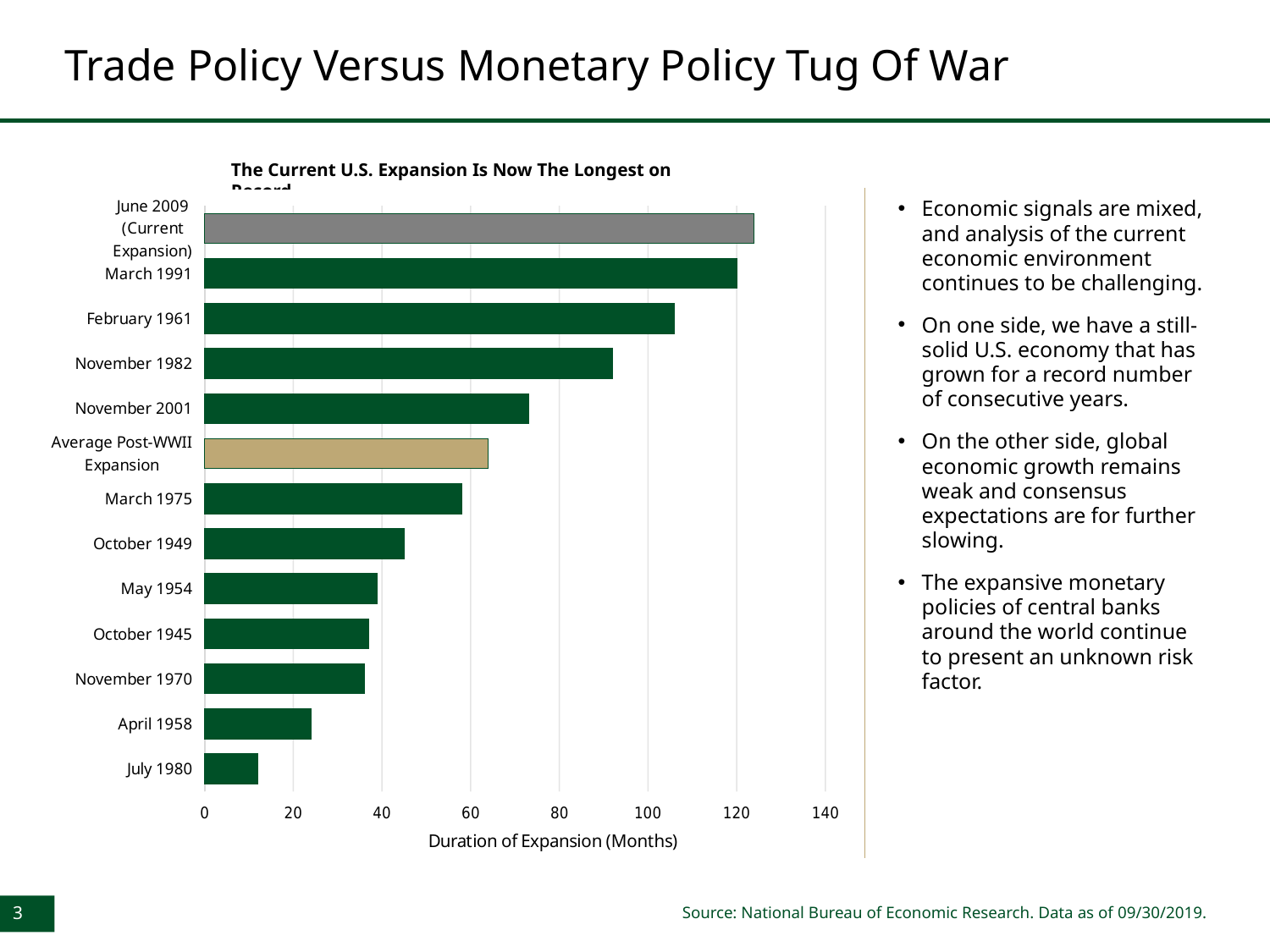
How many bars (expansion periods) are plotted in the chart? 13 Is the duration for October 1949 greater or less than 40 months? greater Is the duration for the Average Post-WWII Expansion greater or less than 60 months? greater Which expansion has the longest duration in the chart? June 2009 (Current Expansion) Which expansion lasted longer, April 1958 or July 1980? April 1958 Is the duration for November 2001 greater or less than 80 months? less What type of chart is shown on the slide? Bar chart Which expansion lasted longer, February 1961 or November 1982? February 1961 What is the label of the horizontal axis of the chart? Duration of Expansion (Months) Which expansion has the shortest duration in the chart? July 1980